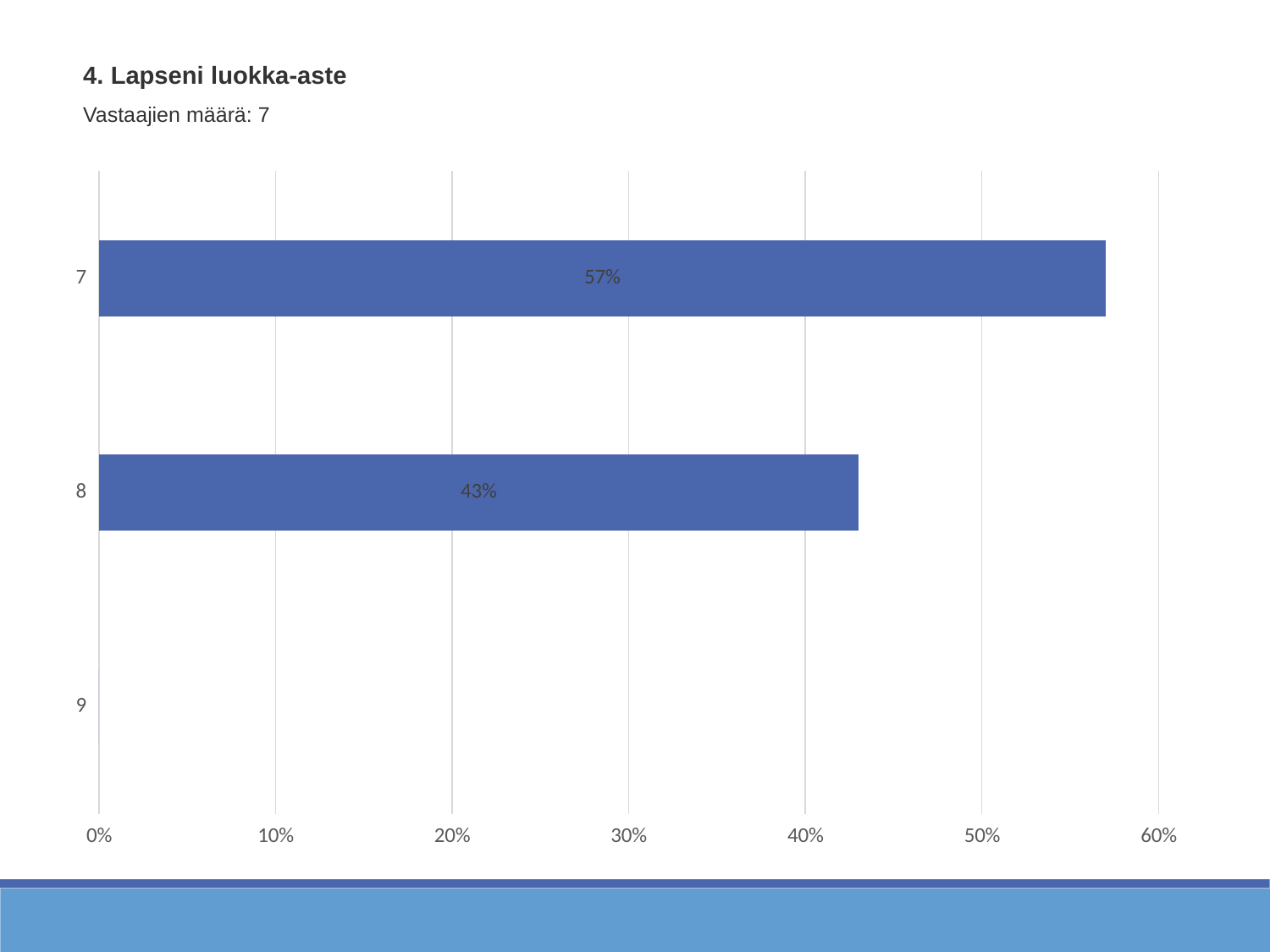
How many categories are shown on the chart? 3 What is the value for category 7? 57% Is the value for category 8 greater or less than 40%? greater Which is larger, the value for category 7 or category 8? 7 What is the number of respondents (Vastaajien määrä) stated on the slide? 7 What is the title of the chart? 4. Lapseni luokka-aste What kind of chart is shown on the slide? bar chart Which category has the highest value? 7 What is the difference between the values for categories 7 and 8? 14% Is the value for category 7 greater or less than 50%? greater Which category has the lowest value? 9 What is the value for category 8? 43%